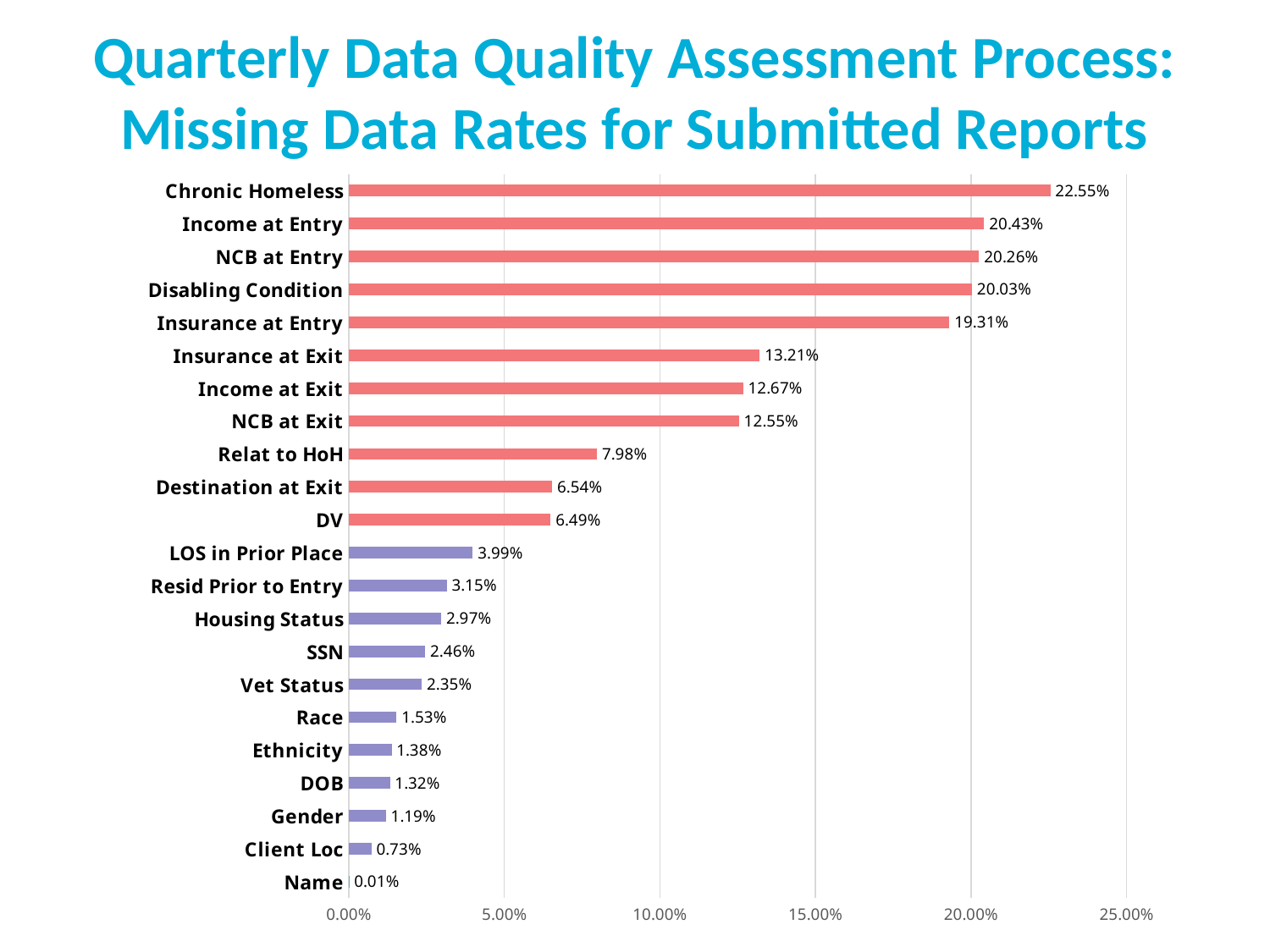
Which category has the lowest missing data rate? Name What kind of chart is shown on the slide? Bar chart What is the missing data rate for SSN? 2.46% How many categories are shown in the chart? 22 What is the difference in percentage points between the missing data rates for Relat to HoH and DV? 1.49 Is the missing data rate for Disabling Condition greater or less than 15.00%? greater What is the difference in percentage points between the missing data rates for Chronic Homeless and Income at Entry? 2.12 Which has a higher missing data rate, Insurance at Entry or Insurance at Exit? Insurance at Entry What is the missing data rate for Insurance at Exit? 13.21% What is the missing data rate for Chronic Homeless? 22.55% Which category has the highest missing data rate? Chronic Homeless What is the highest value shown on the x axis? 25.00%